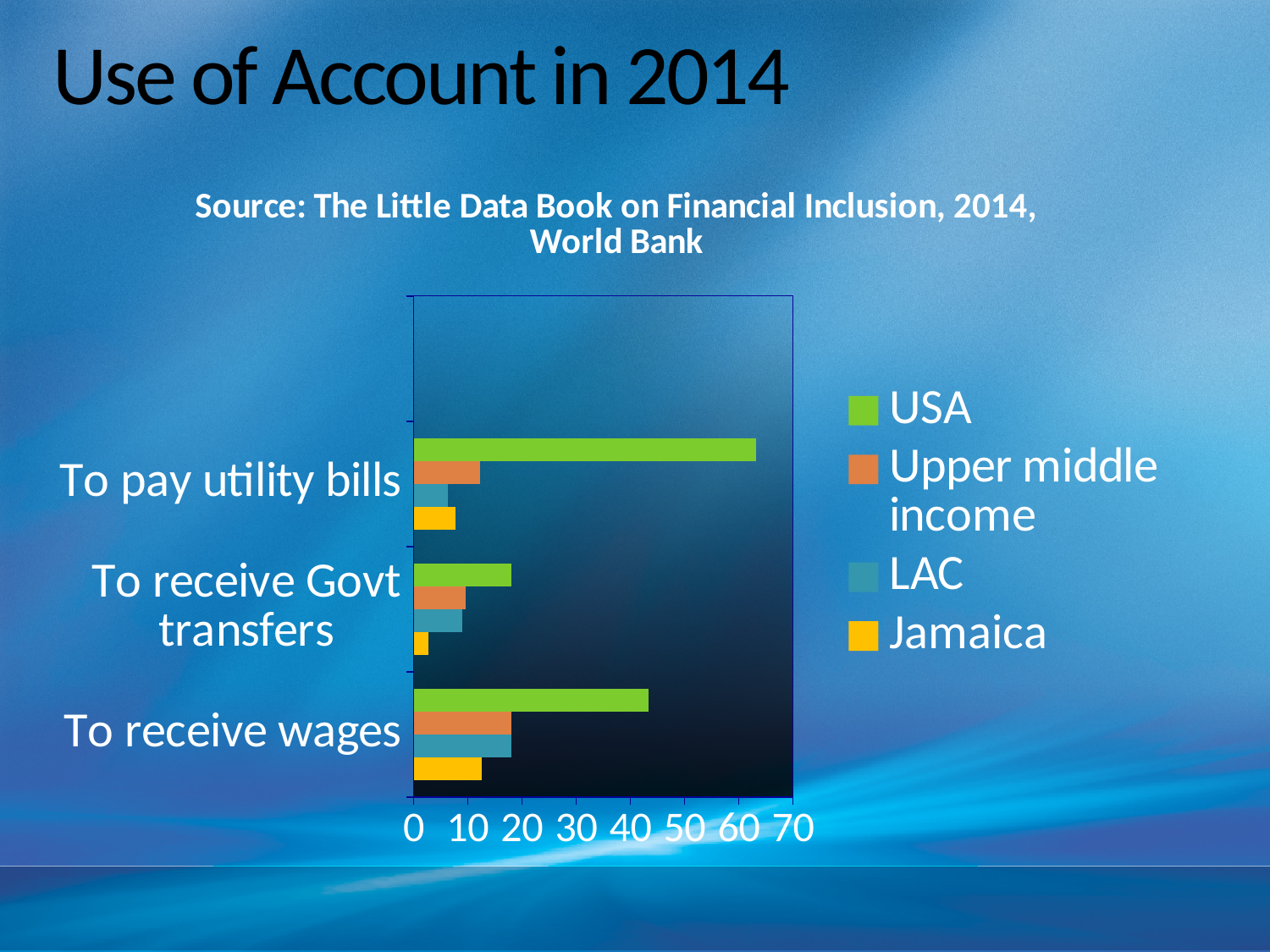
Which series has the lowest value for 'To receive Govt transfers'? Jamaica Is the USA value for 'To receive wages' greater or less than 40? greater Which series has the highest value for 'To receive wages'? USA Which is larger for the USA: the value for 'To pay utility bills' or the value for 'To receive wages'? To pay utility bills Is the Jamaica value for 'To receive Govt transfers' greater or less than 10? less How many categories are shown on the chart? 3 What kind of chart is shown on the slide? Bar chart What is the title of the slide containing the chart? Use of Account in 2014 Is the USA value for 'To pay utility bills' greater or less than 60? greater How many series does the legend list? 4 For the USA series, which category has the highest value? To pay utility bills